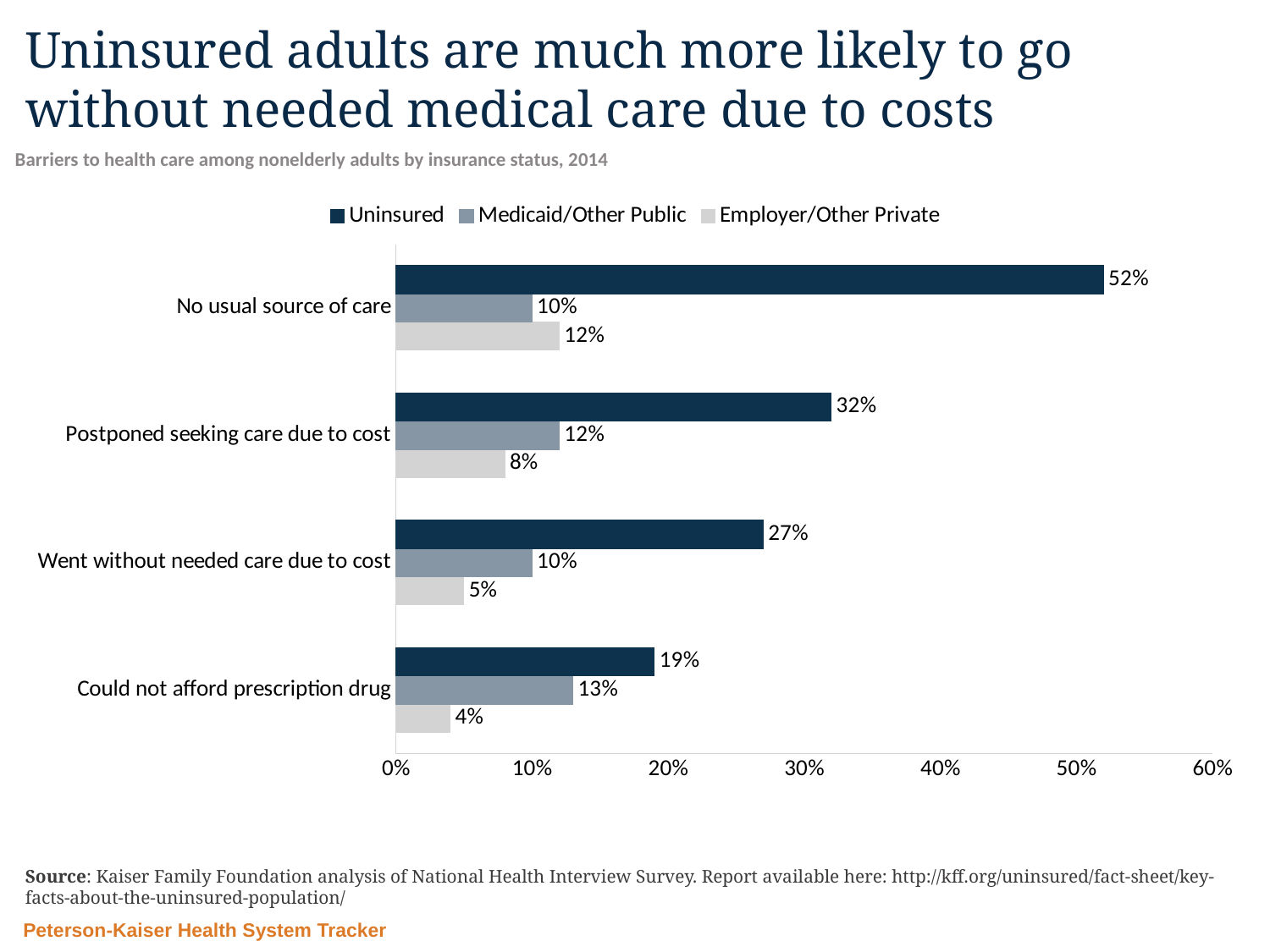
Which category has the highest value for the Uninsured series? No usual source of care What is the value for Uninsured adults with no usual source of care? 52% How many barrier categories are shown on the chart? 4 What is the Medicaid/Other Public value for 'Could not afford prescription drug'? 13% Which category has the lowest value for the Employer/Other Private series? Could not afford prescription drug What is the difference between the Uninsured and Employer/Other Private values for 'Postponed seeking care due to cost'? 24 percentage points Which series is shown in the darkest colour? Uninsured What percentage of Employer/Other Private adults went without needed care due to cost? 5% What kind of chart is shown on the slide? Bar chart For 'No usual source of care', which is larger: the Medicaid/Other Public value or the Employer/Other Private value? Employer/Other Private Is the Uninsured value for 'Went without needed care due to cost' greater or less than 30%? less How many series does the legend list? 3